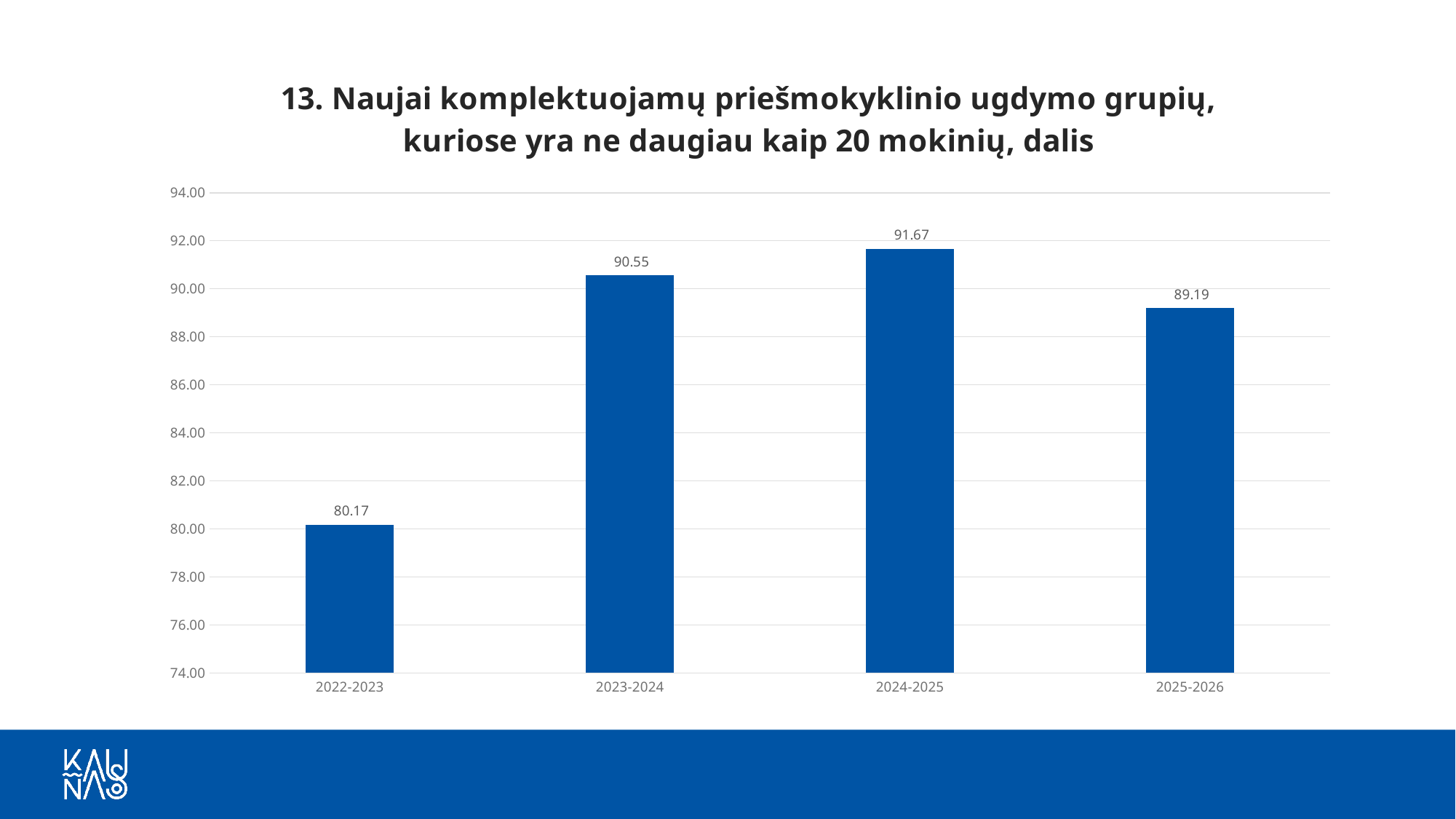
What is the value for 2024-2025? 91.67 What is the value for 2022-2023? 80.17 What is the value for 2023-2024? 90.55 What kind of chart is shown on the slide? bar chart Does the value rise or fall from 2024-2025 to 2025-2026? fall What is the value for 2025-2026? 89.19 Which period has the highest value? 2024-2025 Which is larger, the value for 2023-2024 or the value for 2025-2026? 2023-2024 How many periods are shown on the x axis? 4 What is the difference between the values for 2024-2025 and 2022-2023? 11.50 Which period has the lowest value? 2022-2023 Is the value for 2025-2026 greater or less than 90.00? less